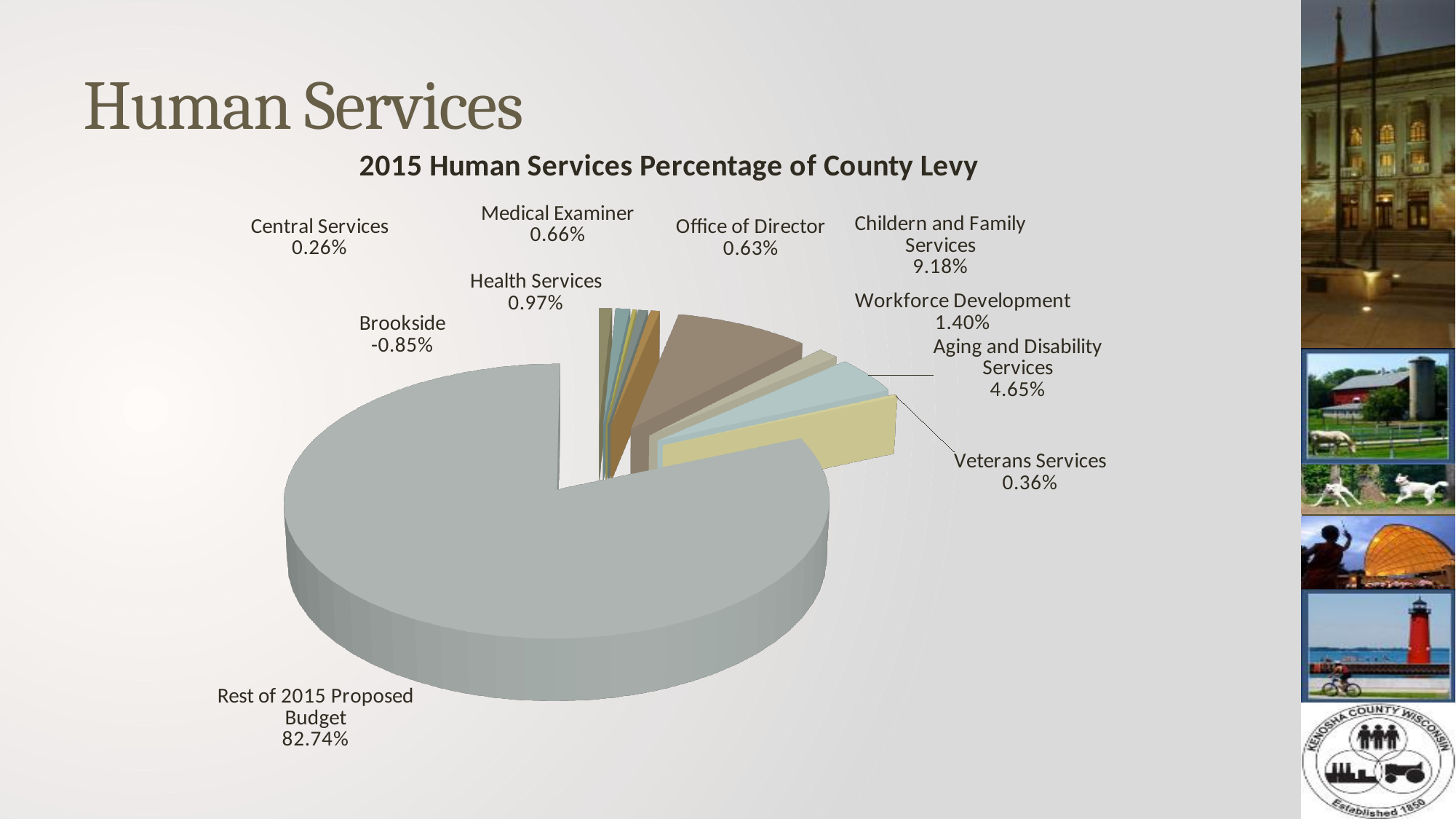
How many categories are labelled on the pie chart? 10 What percentage is shown for Workforce Development? 1.40% What is the difference between Childern and Family Services and Aging and Disability Services? 4.53% What percentage is shown for Veterans Services? 0.36% Which category has the largest share of the pie? Rest of 2015 Proposed Budget What percentage is shown for Aging and Disability Services? 4.65% What percentage is shown for Brookside? -0.85% What kind of chart is shown on the slide? pie chart What percentage is shown for Childern and Family Services? 9.18% What is the title of the chart? 2015 Human Services Percentage of County Levy Which category has the lowest value shown? Brookside Which is larger, Medical Examiner or Office of Director? Medical Examiner